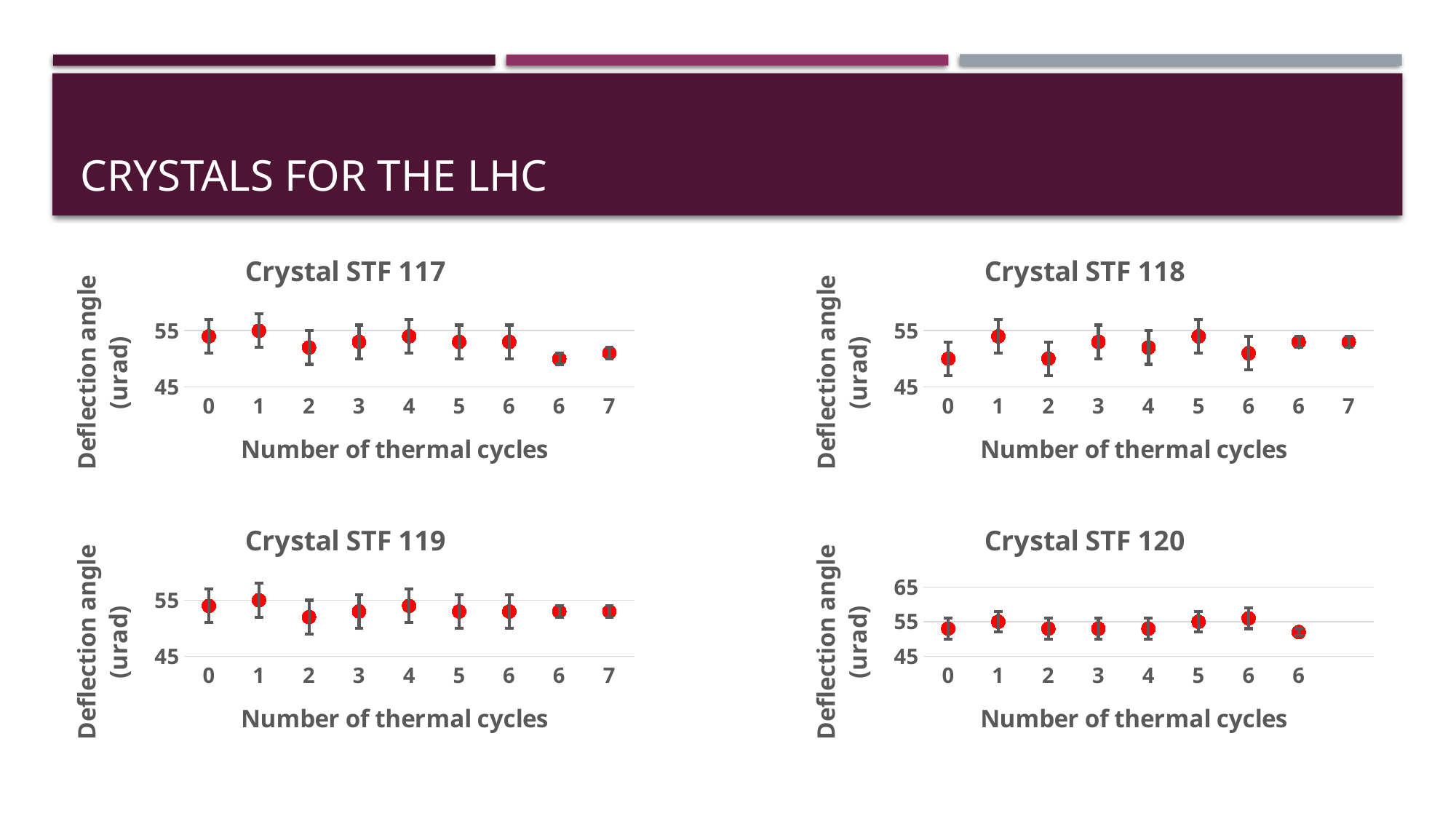
In the Crystal STF 120 chart, is the value at the last point labelled 6 greater or less than 55? less What kind of chart is the Crystal STF 117 chart? scatter chart In the Crystal STF 117 chart, is the value at the second point labelled 6 greater or less than 55? less How many data points are plotted in the Crystal STF 120 chart? 8 In the Crystal STF 117 chart, which is larger: the value at 1 thermal cycle or the value at the second point labelled 6? 1 thermal cycle How many data points are plotted in the Crystal STF 117 chart? 9 In the Crystal STF 118 chart, is the value at 0 thermal cycles greater or less than 55? less What is the x-axis label of the Crystal STF 119 chart? Number of thermal cycles What is the y-axis label of the Crystal STF 118 chart? Deflection angle (urad)